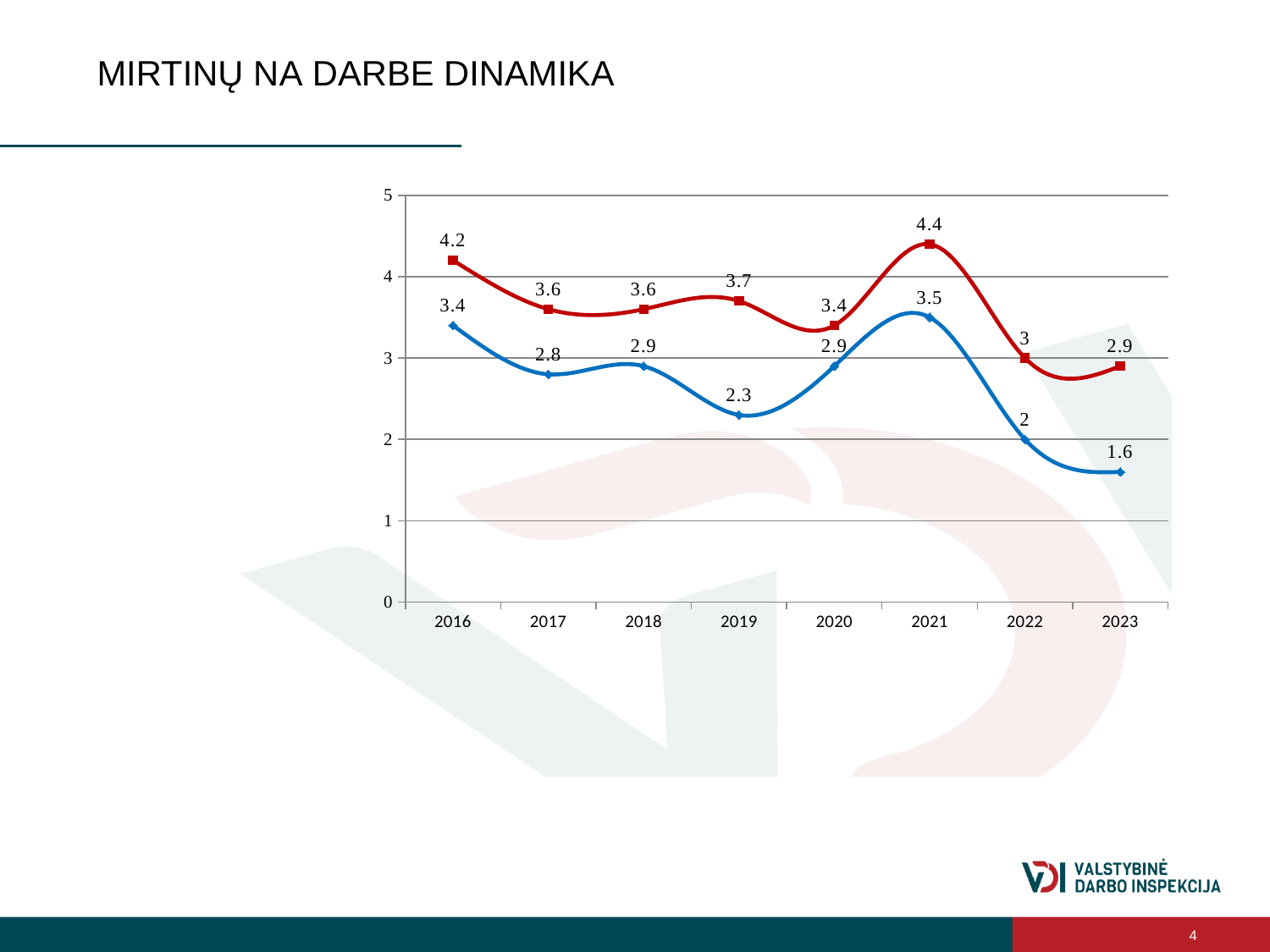
What is the value of the blue line in 2019? 2.3 What is the value of the red line in 2022? 3 What kind of chart is shown on the slide? line chart In which year does the red line reach its highest value? 2021 How many years are shown on the x axis? 8 What is the value of the blue line in 2023? 1.6 Does the blue line rise or fall from 2021 to 2023? fall What is the difference between the red line and the blue line in 2021? 0.9 What is the title of the slide containing the chart? MIRTINŲ NA DARBE DINAMIKA In which year does the blue line reach its lowest value? 2023 Which is larger in 2020, the red line value or the blue line value? the red line What is the value of the red line in 2016? 4.2